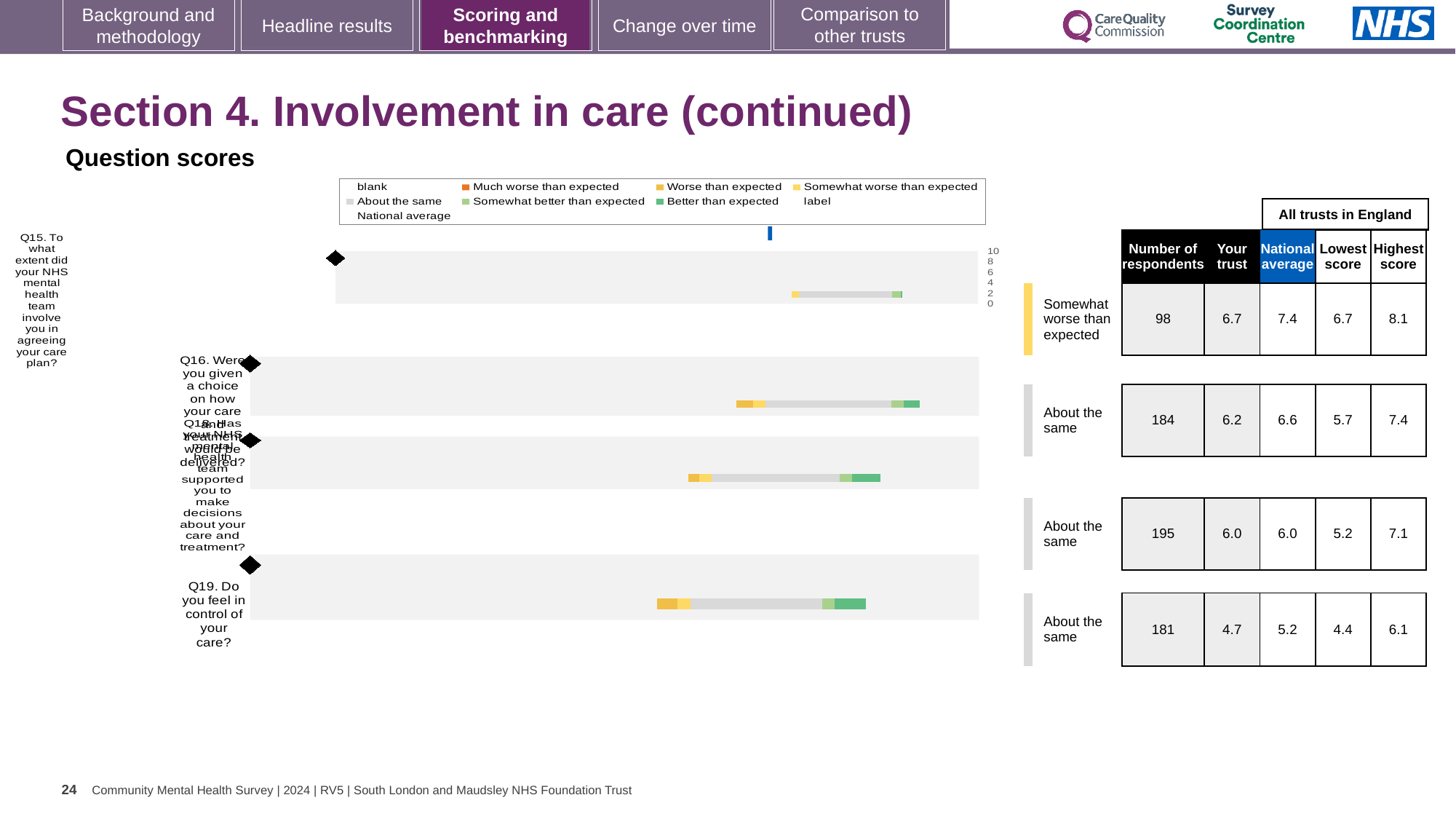
Do the 'Your trust' scores rise or fall going down the chart from Q15 to Q19? fall What benchmark category is shown for Q15 in the question scores chart? Somewhat worse than expected For Q16, which is larger: the 'Your trust' score or the national average? National average How many respondents answered Q18 (supported you to make decisions about your care and treatment)? 195 What is the highest score among all trusts in England for Q19 (do you feel in control of your care)? 6.1 What is the national average score for Q15? 7.4 Which question has the largest number of respondents? Q18 What is the 'Your trust' score for Q15 (involvement in agreeing your care plan)? 6.7 What is the difference between the national average and the 'Your trust' score for Q15? 0.7 How many questions (categories) are plotted in the question scores chart? 4 What kind of chart is used to show the question scores on this slide? bar chart Which question has the lowest 'Your trust' score? Q19